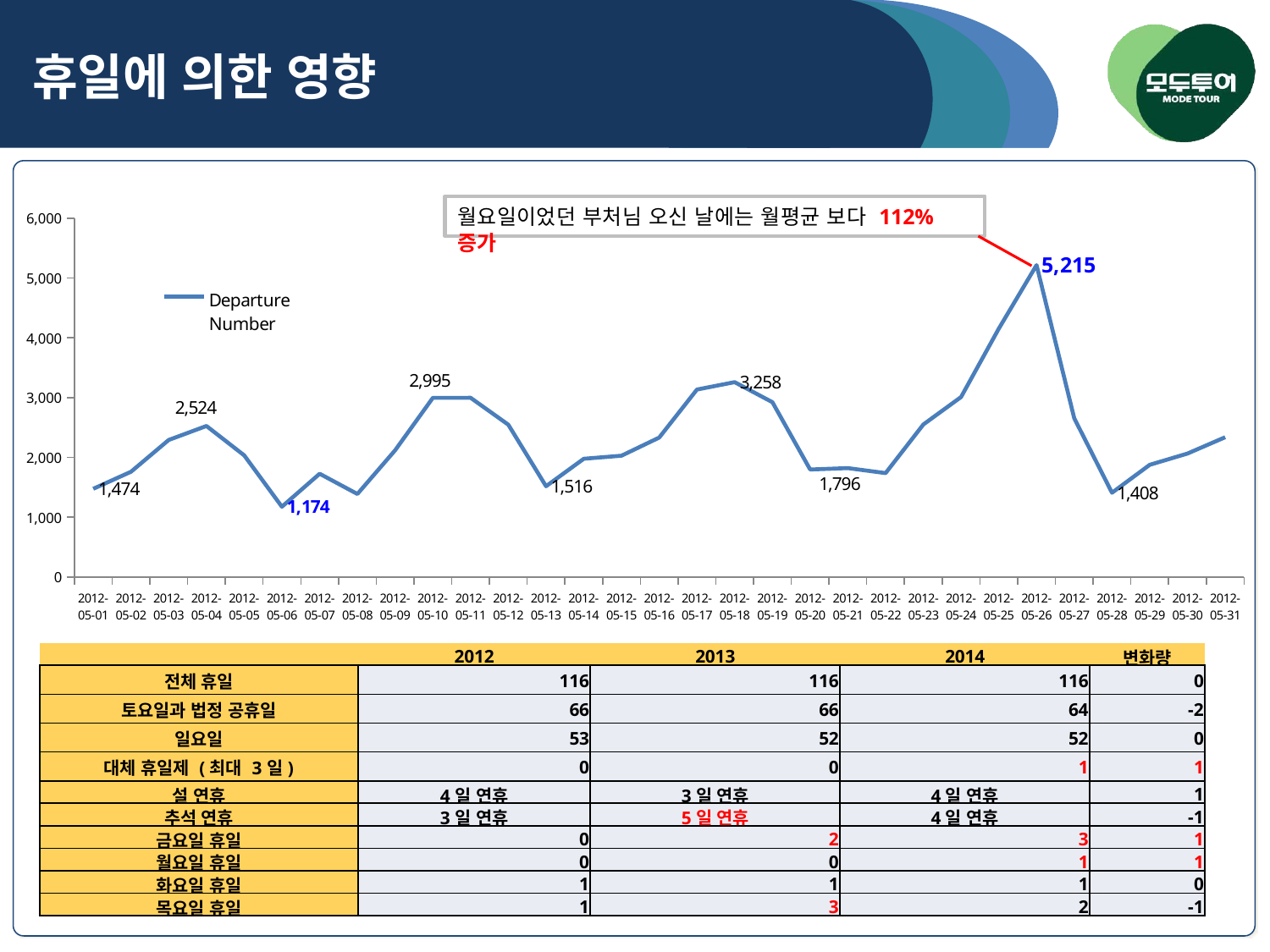
What is the Departure Number on 2012-05-06? 1,174 What is the Departure Number on 2012-05-26? 5,215 How many series does the chart legend list? 1 Which is larger, the Departure Number on 2012-05-10 or on 2012-05-18? 2012-05-18 On which date is the Departure Number lowest? 2012-05-06 Is the Departure Number on 2012-05-24 greater or less than 2,000? greater How many dates are plotted on the x axis of the chart? 31 What is the difference between the Departure Number on 2012-05-26 and on 2012-05-06? 4,041 What kind of chart is shown on the slide? line chart On which date is the Departure Number highest? 2012-05-26 What is the Departure Number on 2012-05-18? 3,258 What is the Departure Number on 2012-05-01? 1,474